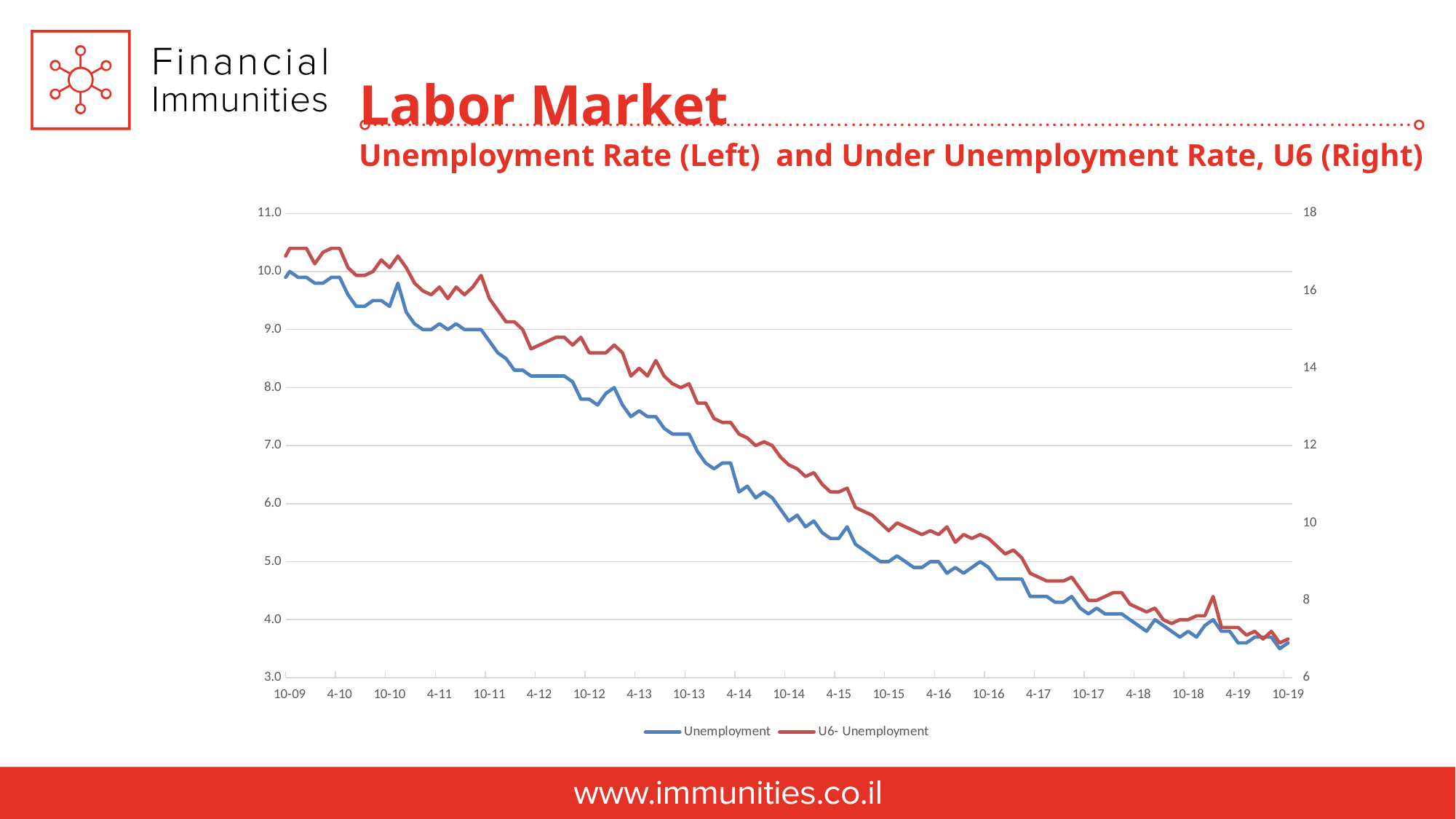
Is the Unemployment value at 4-17 greater or less than 4.0? greater Is the U6- Unemployment value at 10-12 greater or less than 14 on the right axis? greater Is the Unemployment value at 10-14 greater or less than 6.0? less What are the two series named in the legend? Unemployment and U6- Unemployment Do the Unemployment values rise or fall from 10-09 to 10-19? Fall What kind of chart is shown on the slide? Line chart Which series is plotted in red? U6- Unemployment How many series does the legend list? 2 How many date labels are shown on the x axis? 21